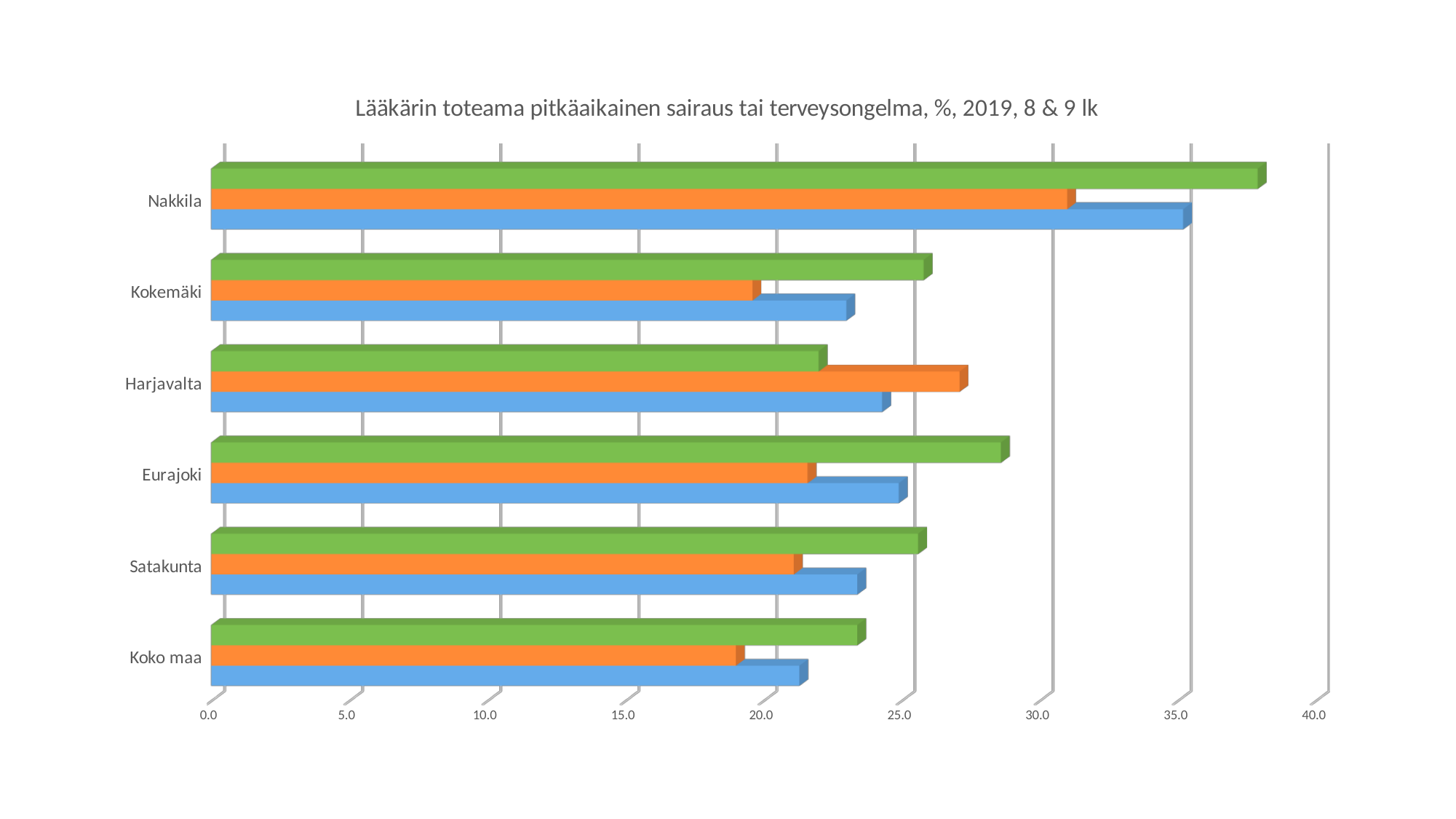
Is the green bar for Nakkila greater or less than 35.0? greater For Harjavalta, which bar is longer, the green bar or the orange bar? orange What kind of chart is shown on the slide? bar chart Which is larger, the green bar for Eurajoki or the green bar for Satakunta? Eurajoki Which category has the longest blue bar? Nakkila Is the blue bar for Koko maa greater or less than 20.0? greater How many bars are shown for each category in the chart? 3 What is the title of the chart? Lääkärin toteama pitkäaikainen sairaus tai terveysongelma, %, 2019, 8 & 9 lk Which category has the shortest orange bar? Koko maa Is the orange bar for Kokemäki greater or less than 20.0? less Which category has the longest green bar? Nakkila How many categories are shown on the vertical axis of the chart? 6